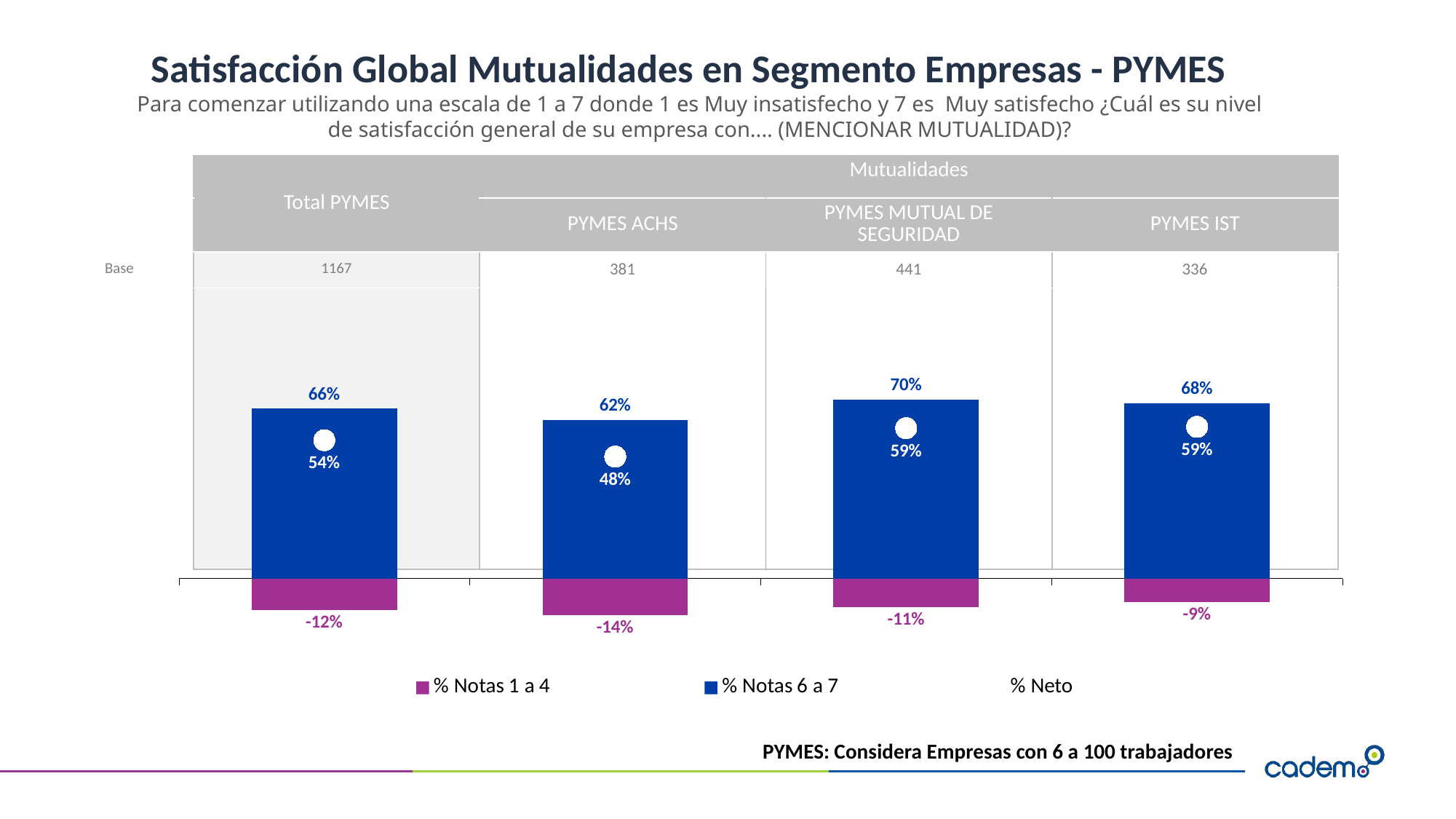
How many categories are shown on the x axis of the chart? 4 What is the % Neto value for Total PYMES? 54% What kind of chart is shown on the slide? Bar chart Which category has the lowest % Neto value? PYMES ACHS What is the difference between the % Notas 6 a 7 values for PYMES MUTUAL DE SEGURIDAD and PYMES ACHS? 8% What is the % Notas 1 a 4 value for PYMES IST? -9% How many series does the legend list? 3 Which is larger, the % Notas 6 a 7 value for PYMES IST or for Total PYMES? PYMES IST What is the Base value shown for PYMES MUTUAL DE SEGURIDAD? 441 What is the % Notas 6 a 7 value for PYMES MUTUAL DE SEGURIDAD? 70% What is the % Notas 6 a 7 value for PYMES ACHS? 62% Which category has the highest % Notas 6 a 7 value? PYMES MUTUAL DE SEGURIDAD